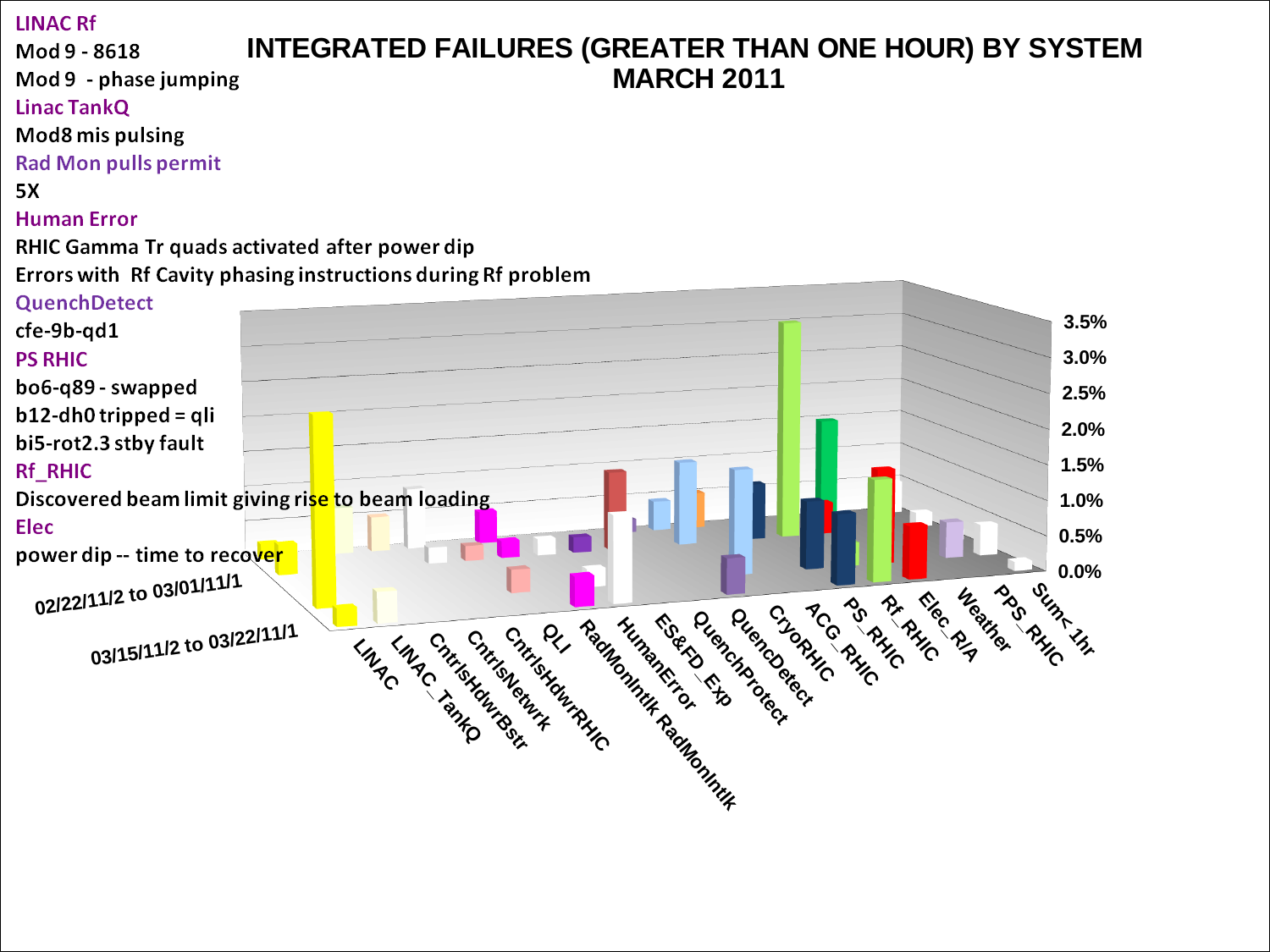
Which is larger in the front row: the yellow bar for LINAC or the bar for CntrlsHdwrBstr? LINAC What is the last category label on the category axis of the chart? Sum< 1hr Which category has the tallest bar in the chart? Rf_RHIC Is the value of the tall yellow bar for LINAC in the front row greater or less than 1.5%? greater What is the highest value shown on the percentage axis of the chart? 3.5% What is the title of the chart? INTEGRATED FAILURES (GREATER THAN ONE HOUR) BY SYSTEM MARCH 2011 What kind of chart is shown on the slide? bar chart How many system categories are listed along the category axis of the chart? 19